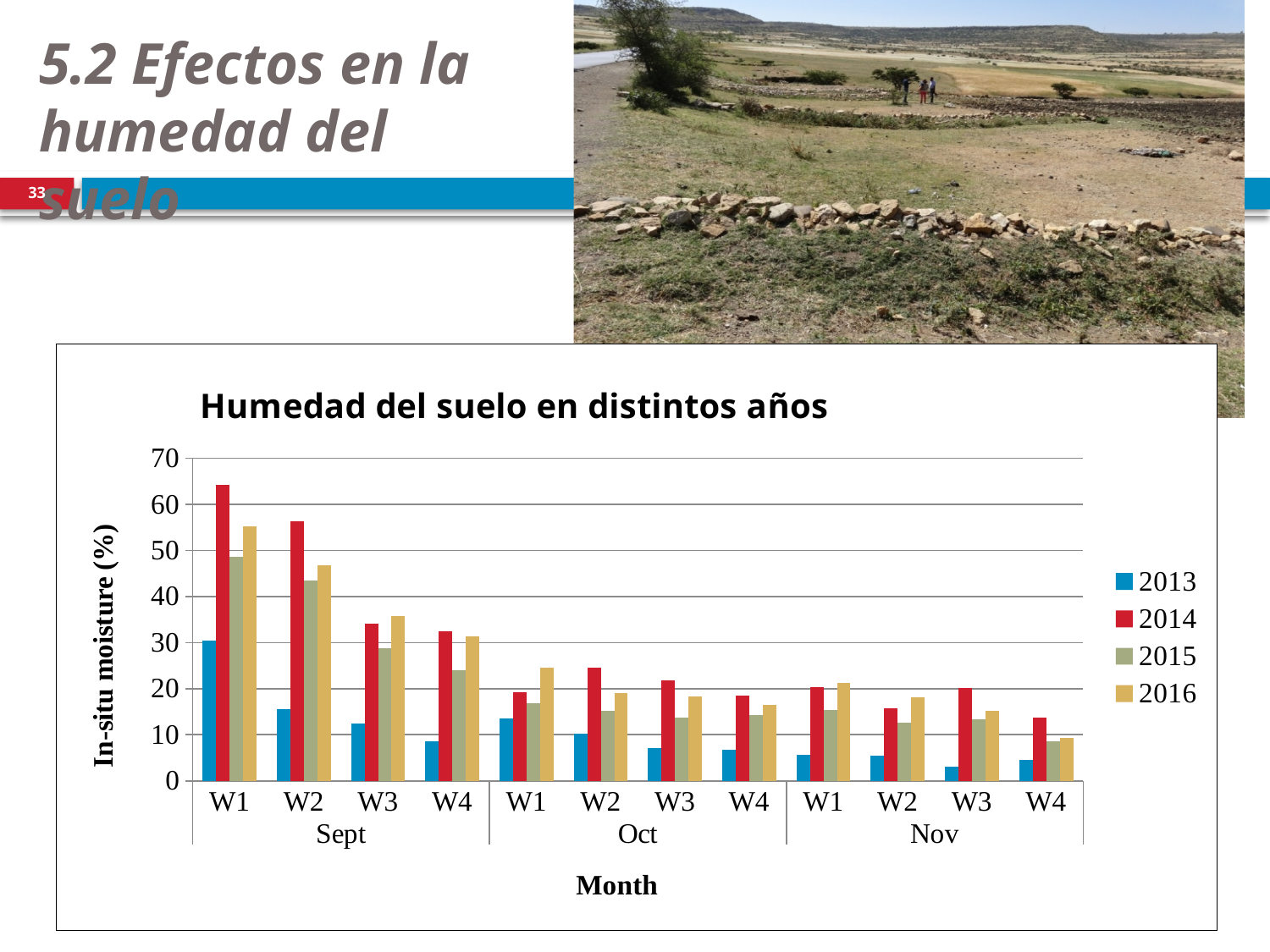
Is the value for 2016 in Sept W1 greater or less than 50? greater How many week categories are shown along the x axis? 12 How many series does the legend list? 4 Is the value for 2013 in Nov W3 greater or less than 10? less Is the value for 2014 in Sept W1 greater or less than 60? greater What is the title of the chart? Humedad del suelo en distintos años Do the values for 2014 rise or fall from Sept W1 to Sept W4? fall What is the label of the vertical axis? In-situ moisture (%) Which is larger in Oct W1, the value for 2015 or the value for 2016? 2016 What kind of chart is shown on the slide? bar chart Which year has the highest value in Sept W1? 2014 Which year has the lowest value in Sept W1? 2013